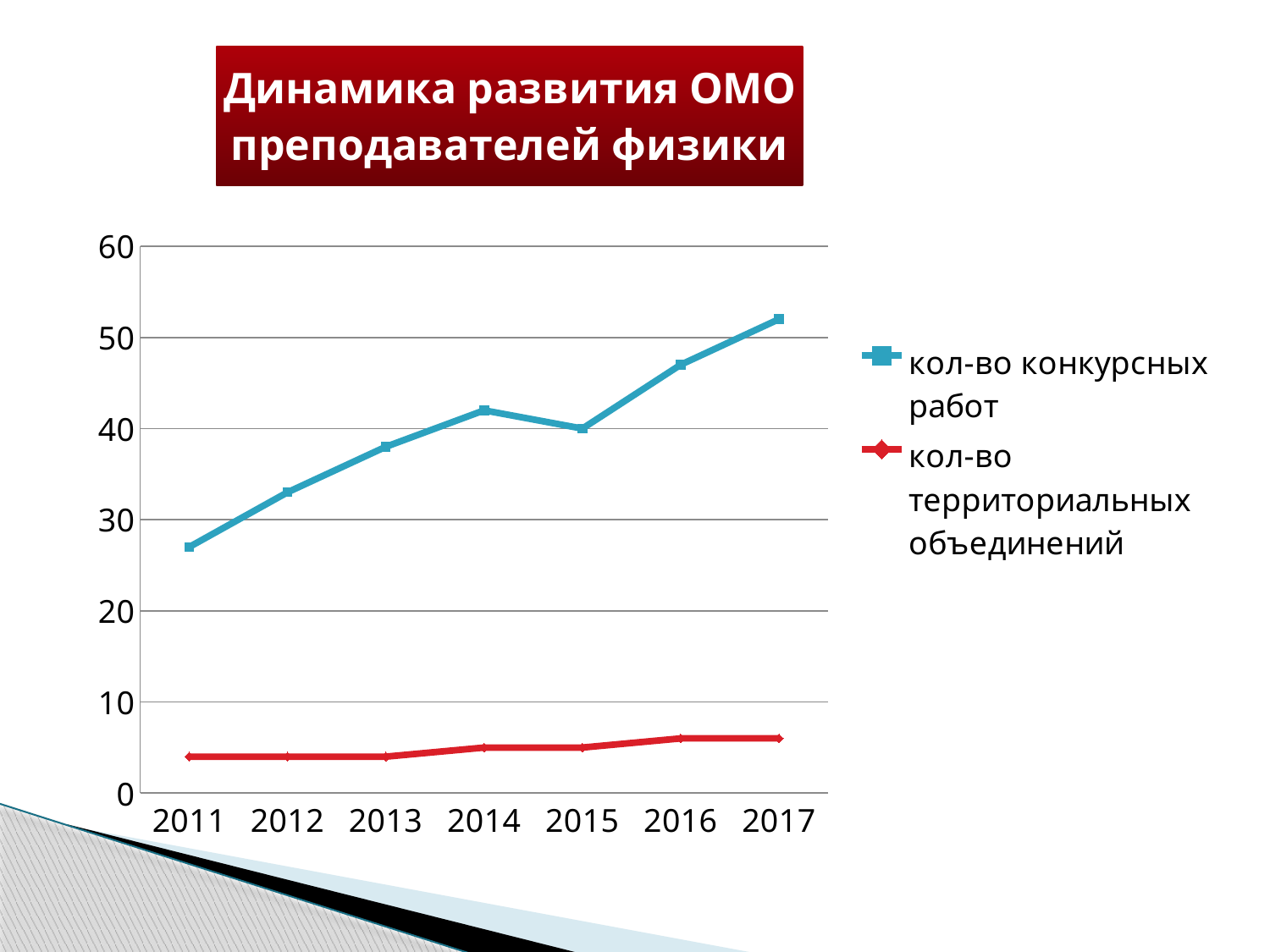
Is the value for "кол-во территориальных объединений" in 2017 greater or less than 10? less How many series does the legend list? 2 How many years are plotted along the x axis? 7 Which is larger for "кол-во конкурсных работ": the value in 2014 or the value in 2015? 2014 What kind of chart is shown on the slide? line chart Is the value for "кол-во конкурсных работ" in 2011 greater or less than 30? less Is the value for "кол-во конкурсных работ" in 2017 greater or less than 50? greater In which year is the value for "кол-во конкурсных работ" highest? 2017 Does the value for "кол-во конкурсных работ" generally rise or fall from 2011 to 2017? rise In which year is the value for "кол-во конкурсных работ" lowest? 2011 What colour is the line for "кол-во территориальных объединений"? red Which series has the larger value in 2014, "кол-во конкурсных работ" or "кол-во территориальных объединений"? кол-во конкурсных работ